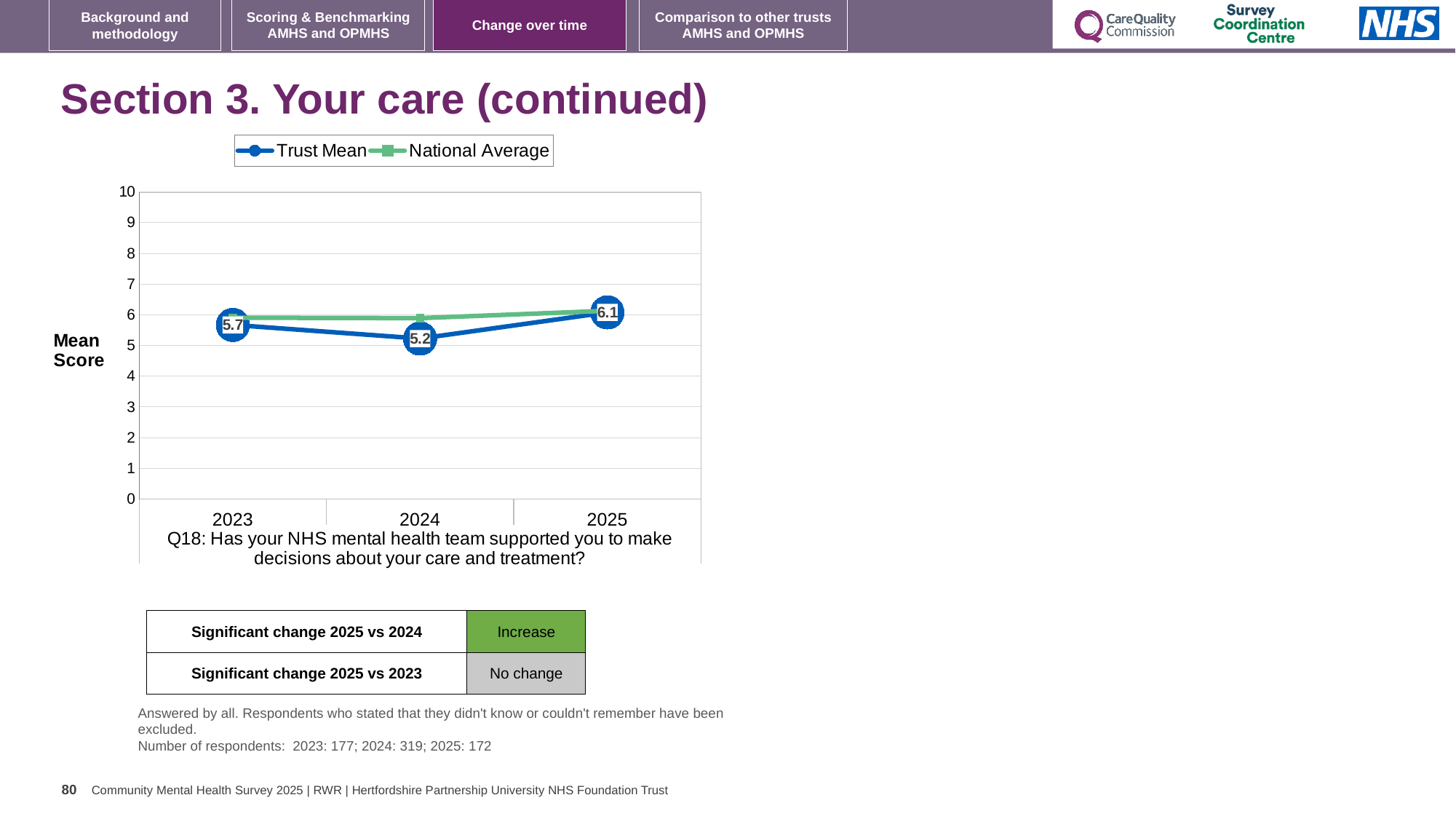
What is the difference between the Trust Mean scores for 2025 and 2024? 0.9 What is the Trust Mean score for 2023? 5.7 Does the Trust Mean rise or fall from 2024 to 2025? rise In 2024, which is higher: the Trust Mean or the National Average? National Average What kind of chart is shown on the slide? line chart What is the Trust Mean score for 2024? 5.2 In which year is the Trust Mean score lowest? 2024 Is the National Average value for 2023 greater or less than 5? greater How many series does the legend list? 2 How many years are shown on the x axis? 3 In which year is the Trust Mean score highest? 2025 What is the Trust Mean score for 2025? 6.1